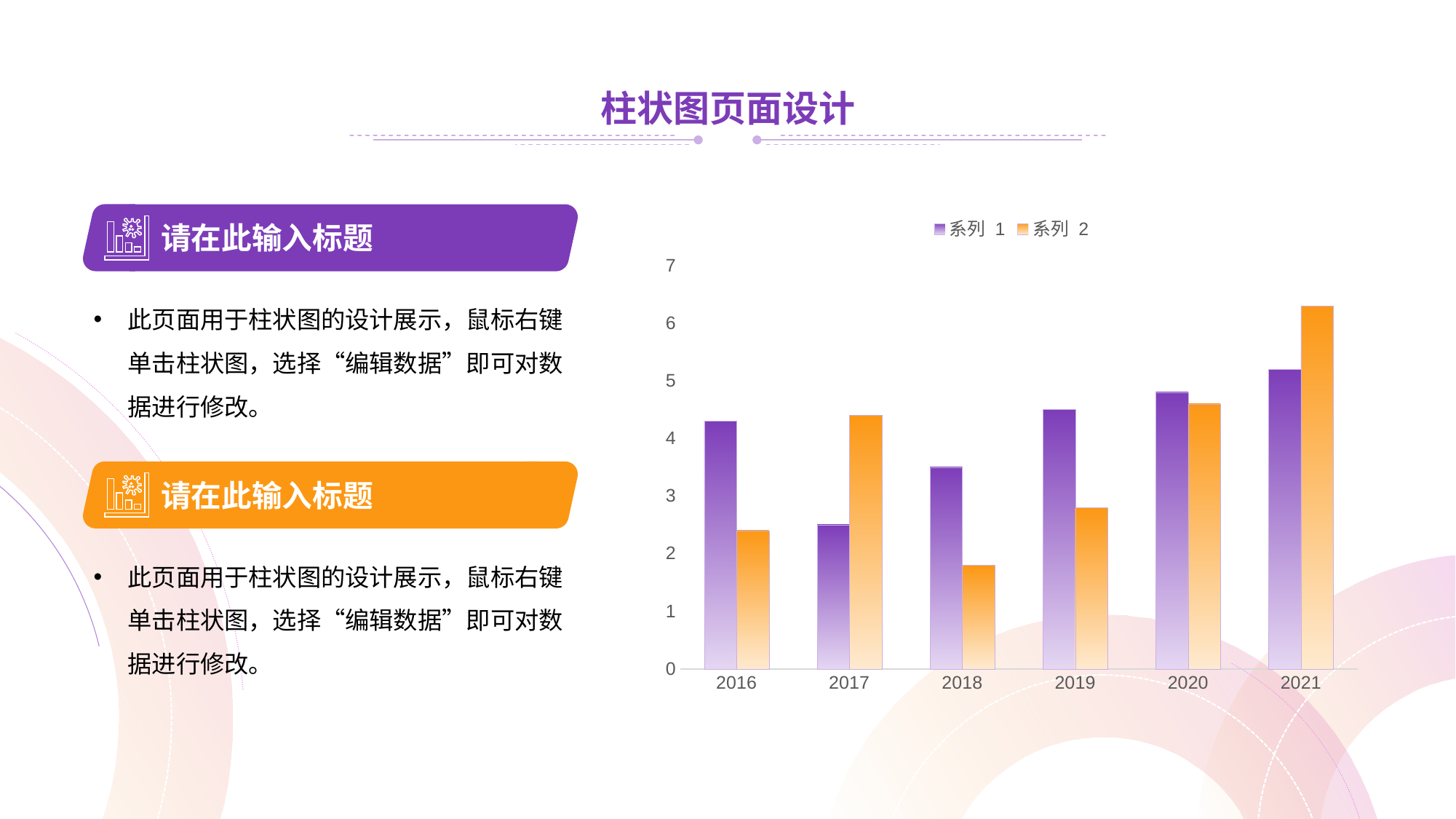
Which year has the lowest value for 系列 2? 2018 Which year has the highest value for 系列 2? 2021 Is the value for 系列 2 in 2021 greater or less than 6? greater What kind of chart is shown on the slide? bar chart Do the values for 系列 1 rise or fall from 2018 to 2021? rise Which year has the highest value for 系列 1? 2021 In 2017, which series has the larger value, 系列 1 or 系列 2? 系列 2 Is the value for 系列 2 in 2018 greater or less than 2? less How many series does the legend list? 2 Which year has the lowest value for 系列 1? 2017 In 2016, which series has the larger value, 系列 1 or 系列 2? 系列 1 How many years are shown on the x axis? 6